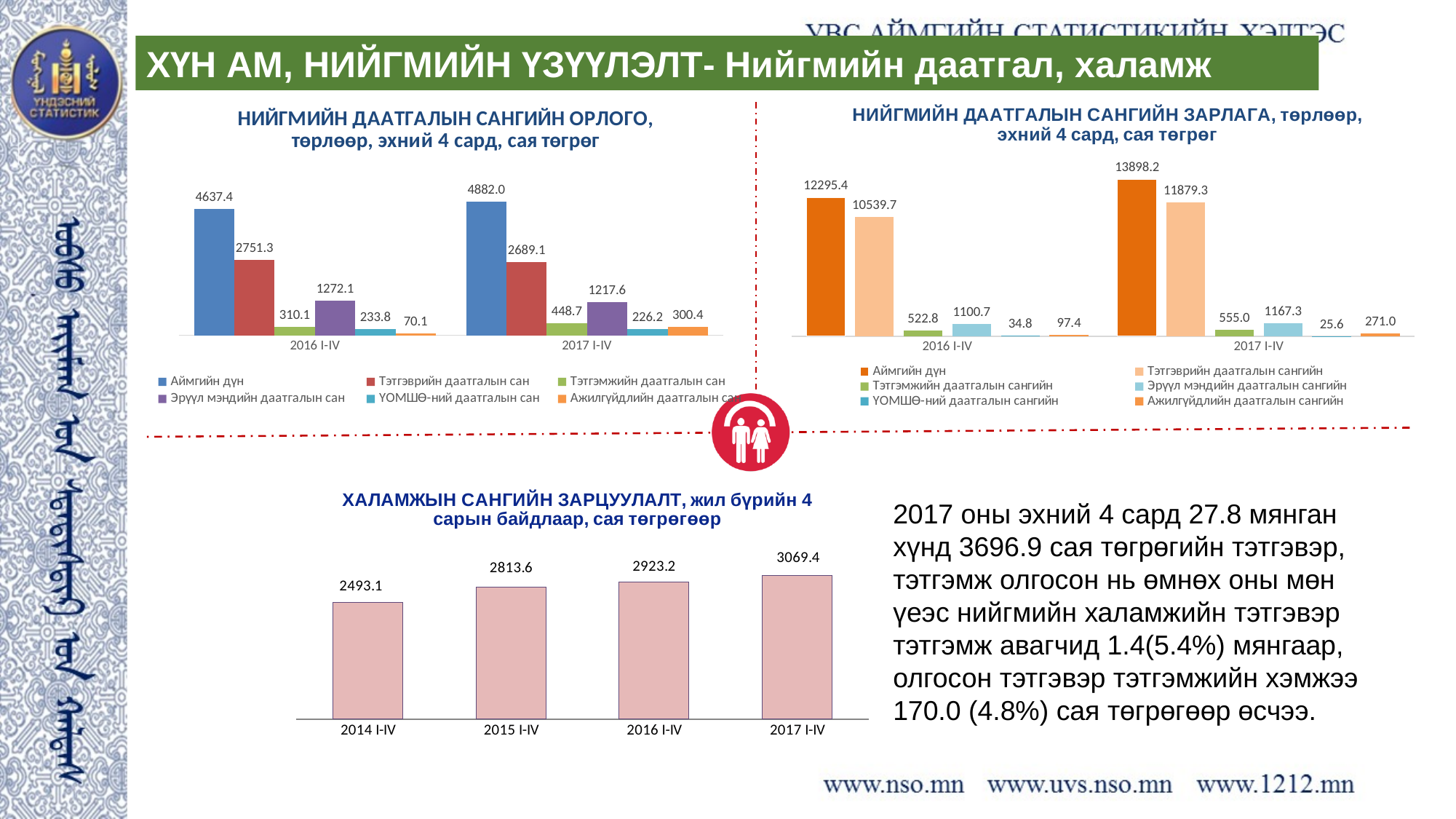
In the bottom chart (ХАЛАМЖЫН САНГИЙН ЗАРЦУУЛАЛТ), which category has the lowest value? 2014 I-IV In the top-left chart (НИЙГМИЙН ДААТГАЛЫН САНГИЙН ОРЛОГО), which is larger: Тэтгэврийн даатгалын сан in 2016 I-IV or in 2017 I-IV? 2016 I-IV In the bottom chart (ХАЛАМЖЫН САНГИЙН ЗАРЦУУЛАЛТ), what is the difference between the 2015 I-IV and 2014 I-IV values? 320.5 In the top-left chart (НИЙГМИЙН ДААТГАЛЫН САНГИЙН ОРЛОГО), what is the value of Ажилгүйдлийн даатгалын сан for 2016 I-IV? 70.1 In the top-right chart (НИЙГМИЙН ДААТГАЛЫН САНГИЙН ЗАРЛАГА), what is the value of Тэтгэврийн даатгалын сангийн for 2017 I-IV? 11879.3 In the bottom chart (ХАЛАМЖЫН САНГИЙН ЗАРЦУУЛАЛТ), what is the value for 2017 I-IV? 3069.4 What type of chart is the top-right chart (НИЙГМИЙН ДААТГАЛЫН САНГИЙН ЗАРЛАГА)? bar chart In the top-right chart (НИЙГМИЙН ДААТГАЛЫН САНГИЙН ЗАРЛАГА), what is the difference between Аймгийн дүн in 2017 I-IV and in 2016 I-IV? 1602.8 How many categories are shown on the x axis of the bottom chart (ХАЛАМЖЫН САНГИЙН ЗАРЦУУЛАЛТ)? 4 In the top-left chart (НИЙГМИЙН ДААТГАЛЫН САНГИЙН ОРЛОГО), what is the value of Аймгийн дүн for 2017 I-IV? 4882.0 In the bottom chart (ХАЛАМЖЫН САНГИЙН ЗАРЦУУЛАЛТ), do the values rise or fall from 2014 I-IV to 2017 I-IV? rise How many series does the legend of the top-left chart (НИЙГМИЙН ДААТГАЛЫН САНГИЙН ОРЛОГО) list? 6